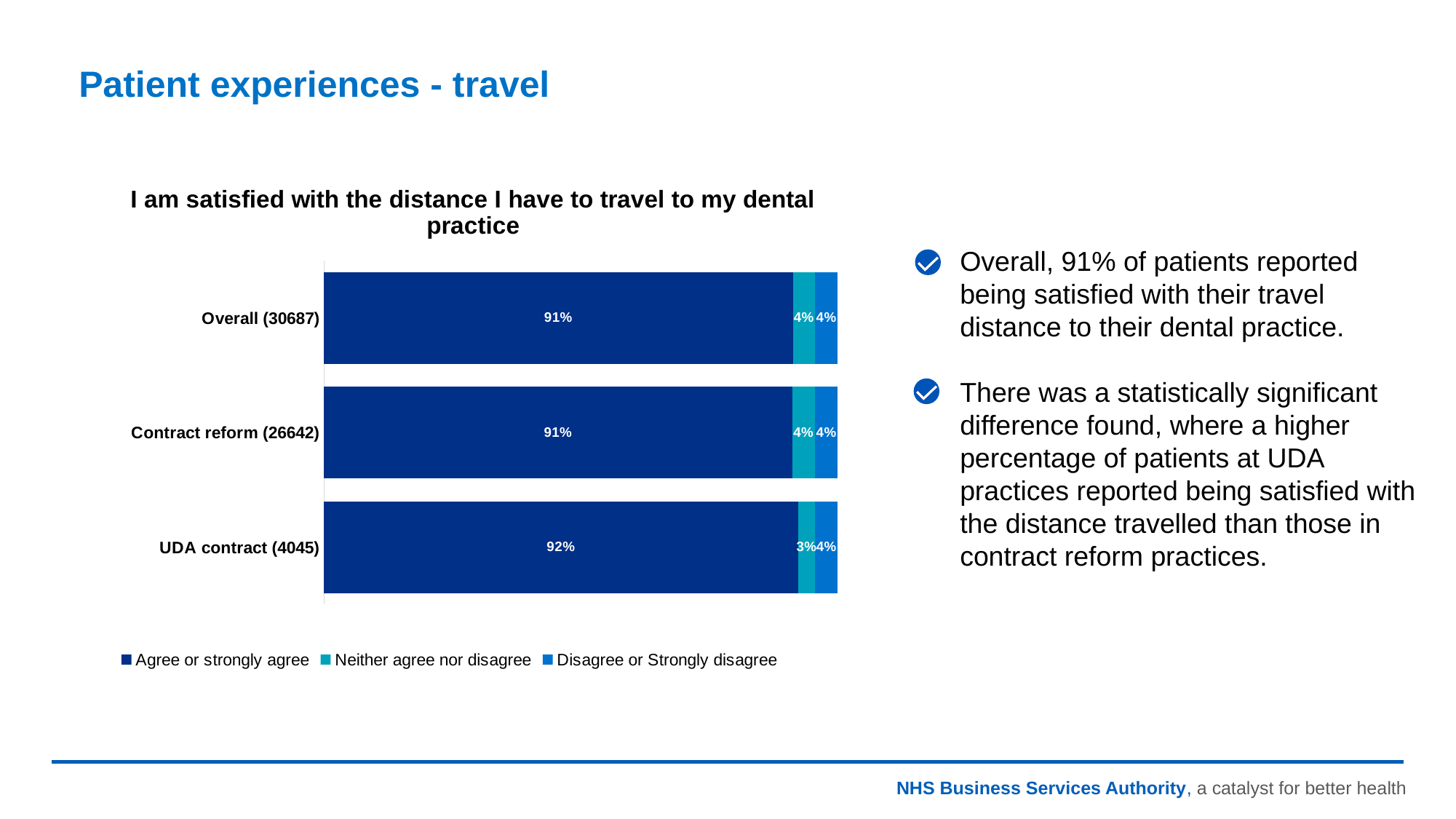
What percentage of patients in the UDA contract (4045) group neither agree nor disagree? 3% Which is larger: the 'Neither agree nor disagree' percentage for Contract reform (26642) or for UDA contract (4045)? Contract reform (26642) What percentage of patients in the UDA contract (4045) group agree or strongly agree? 92% Which group has the highest percentage of patients who agree or strongly agree? UDA contract (4045) What type of chart is shown on the slide? Stacked bar chart How many series does the legend list? 3 What percentage of patients in the Contract reform (26642) group neither agree nor disagree? 4% What is the difference in the 'Agree or strongly agree' percentage between the UDA contract (4045) group and the Contract reform (26642) group? 1% What is the title of the chart? I am satisfied with the distance I have to travel to my dental practice What percentage of patients in the UDA contract (4045) group disagree or strongly disagree? 4% What percentage of patients in the Overall (30687) group agree or strongly agree that they are satisfied with the distance they have to travel to their dental practice? 91% How many groups (bars) are shown in the chart? 3